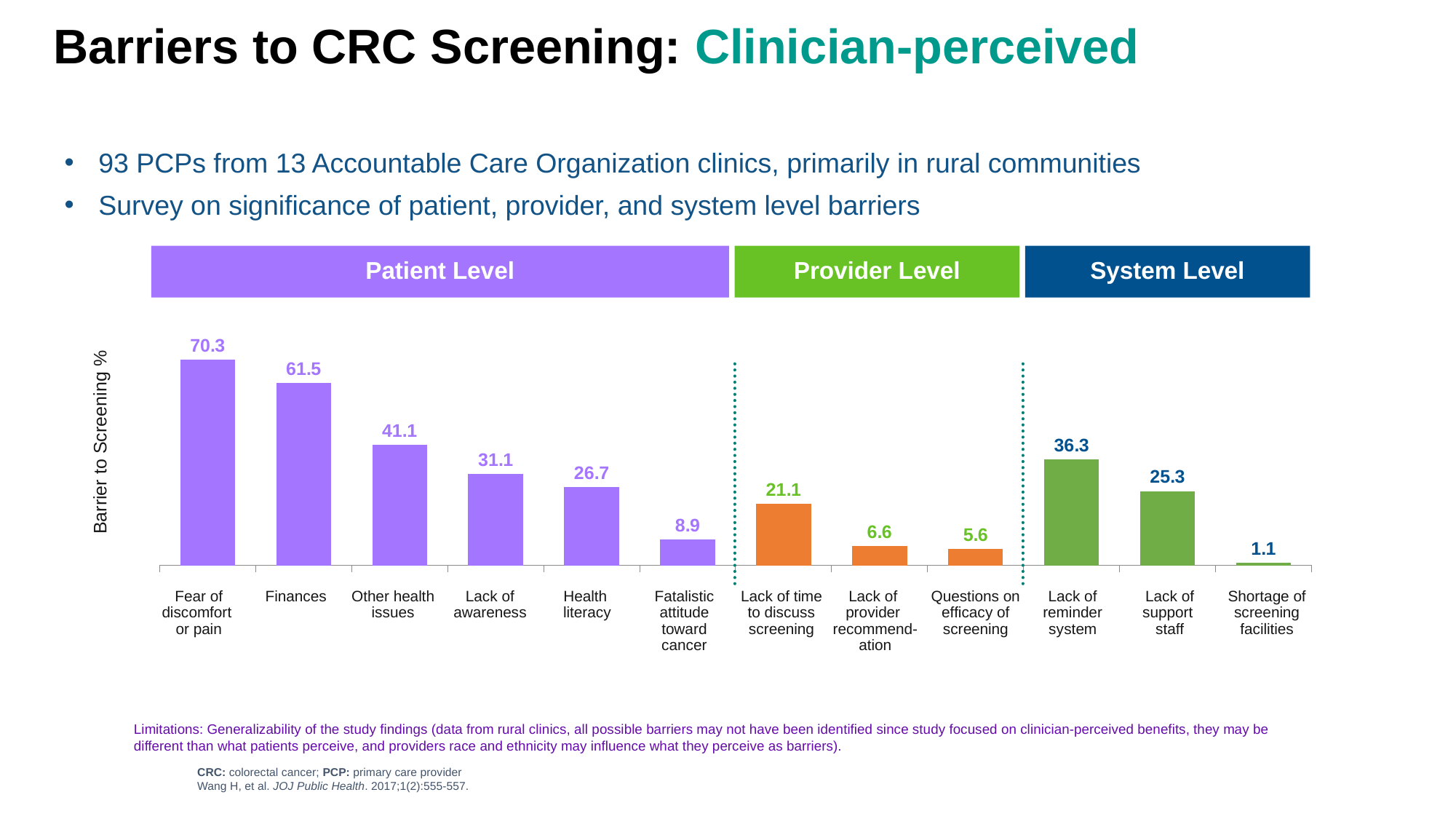
What is the value for Fear of discomfort or pain? 70.3 How many barriers are plotted in the chart? 12 What is the difference between the values for Finances and Other health issues? 20.4 What is the difference between the values for Lack of reminder system and Lack of support staff? 11.0 How many barriers are grouped under Provider Level? 3 What is the label of the y axis? Barrier to Screening % What kind of chart is shown on the slide? Bar chart Which barrier has the lowest value? Shortage of screening facilities What is the value for Lack of reminder system? 36.3 What is the value for Lack of time to discuss screening? 21.1 Which is larger, the value for Health literacy or the value for Lack of time to discuss screening? Health literacy Which barrier has the highest value? Fear of discomfort or pain